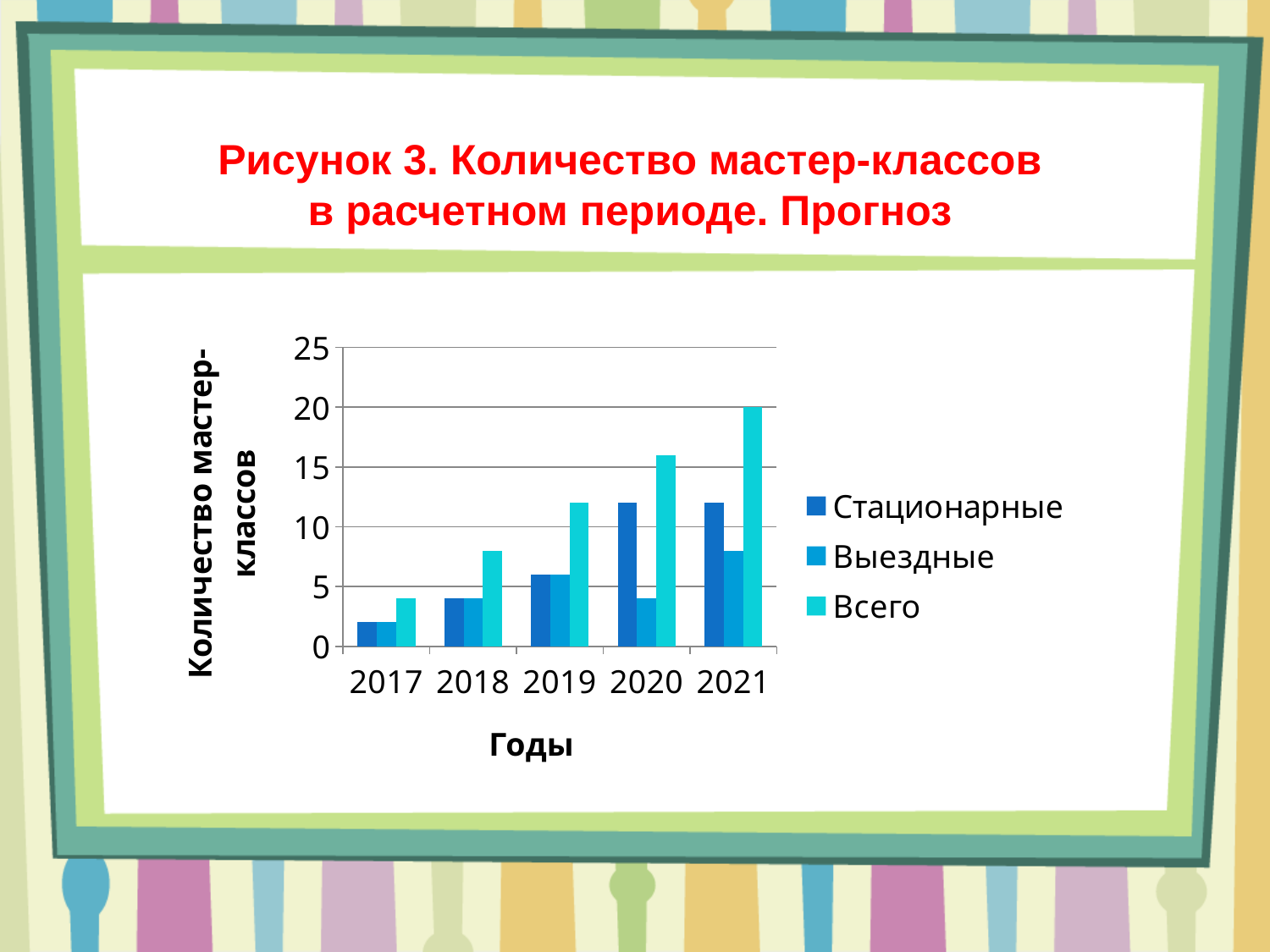
How many years are shown on the x axis? 5 Is the value of Выездные for 2021 greater or less than 10? less What is the title of the x axis? Годы Do the Всего values rise or fall from 2017 to 2021? rise In 2020, which is larger: Стационарные or Выездные? Стационарные How many series does the legend list? 3 Is the value of Всего for 2017 greater or less than 5? less Is the value of Всего for 2020 greater or less than 15? greater In which year is the Всего bar lowest? 2017 What kind of chart is shown on the slide? bar chart What is the value of Всего for 2021? 20 In which year is the Всего bar highest? 2021